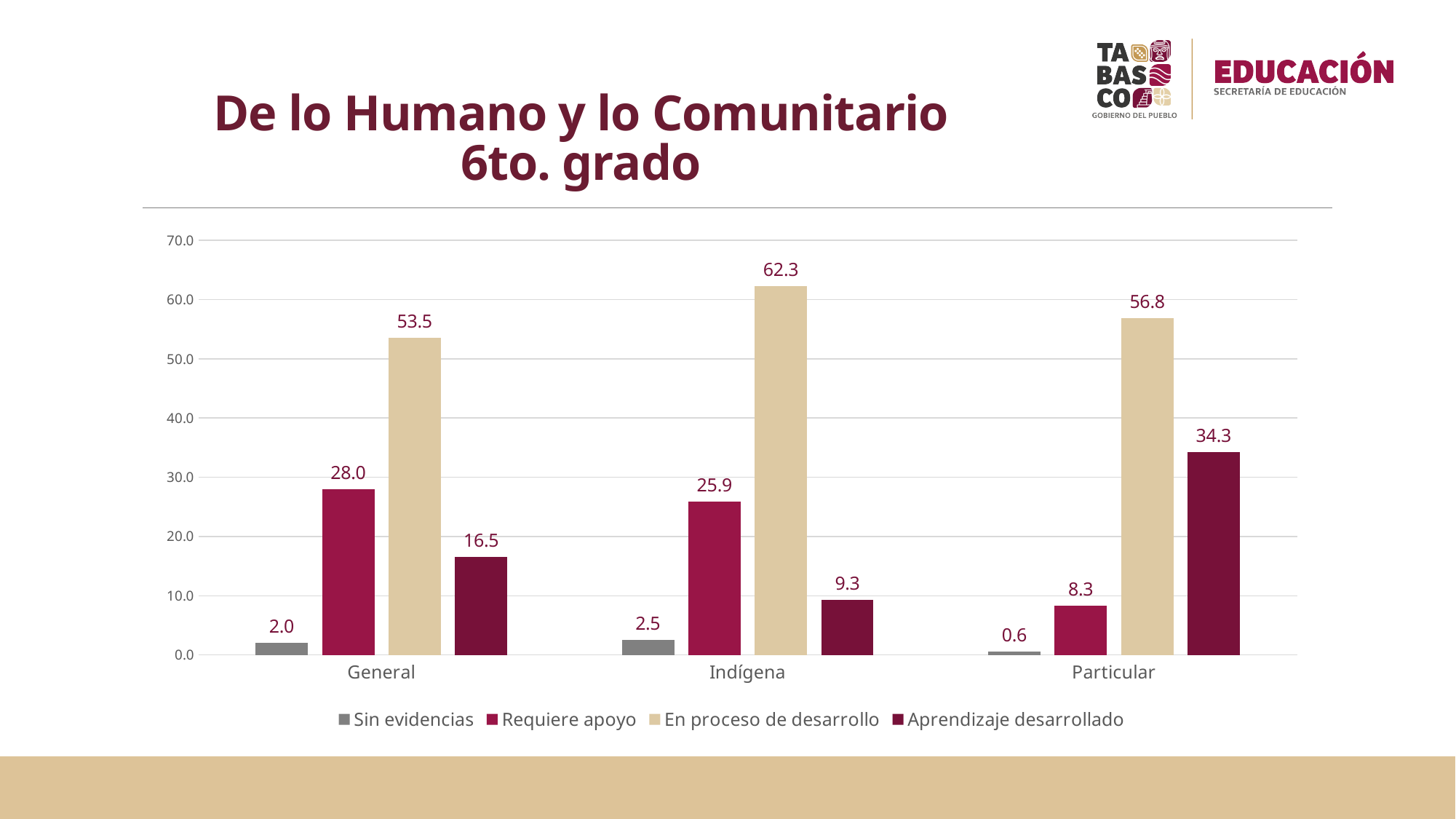
Which category has the lowest value for 'Sin evidencias'? Particular What is the value for 'Sin evidencias' in the General category? 2.0 Is the value for 'En proceso de desarrollo' in the Particular category greater or less than 50.0? greater What is the title of the slide? De lo Humano y lo Comunitario 6to. grado What is the value for 'En proceso de desarrollo' in the Indígena category? 62.3 Which is larger: 'Aprendizaje desarrollado' for General or for Indígena? General How many categories are shown on the x axis? 3 What kind of chart is shown on the slide? Bar chart Which category has the highest value for 'Requiere apoyo'? General What is the value for 'Aprendizaje desarrollado' in the Particular category? 34.3 What is the difference between the 'En proceso de desarrollo' values for Indígena and General? 8.8 How many series does the legend list? 4